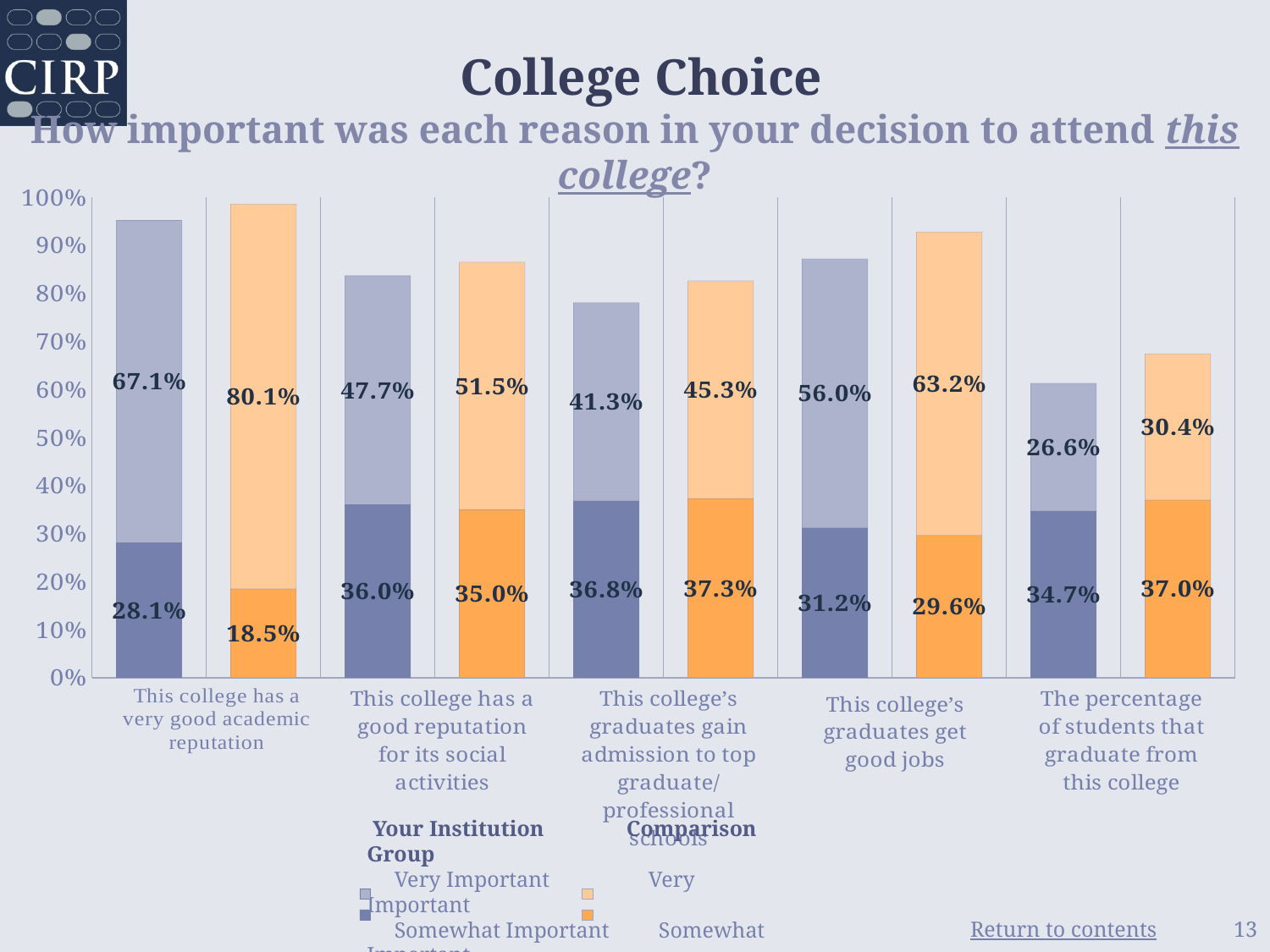
What is the total height of the Your Institution stacked bar for 'This college has a very good academic reputation'? 95.2% What is the difference between the Comparison Group's and Your Institution's Very Important values for 'This college has a very good academic reputation'? 13.0% Which reason has the lowest Very Important percentage for Your Institution? The percentage of students that graduate from this college How many series does the legend list? 4 Which reason has the highest Very Important percentage for the Comparison Group? This college has a very good academic reputation What is the Comparison Group's Very Important value for 'This college's graduates get good jobs'? 63.2% What percentage of the Comparison Group rated 'This college has a very good academic reputation' as Somewhat Important? 18.5% What kind of chart is shown on the slide? Stacked bar chart What percentage of Your Institution students rated 'This college has a very good academic reputation' as Very Important? 67.1% What is Your Institution's Somewhat Important value for 'The percentage of students that graduate from this college'? 34.7% For 'This college's graduates get good jobs', which is larger: Your Institution's Very Important value or the Comparison Group's Very Important value? Comparison Group (63.2%) How many reasons (categories) are shown along the x axis? 5